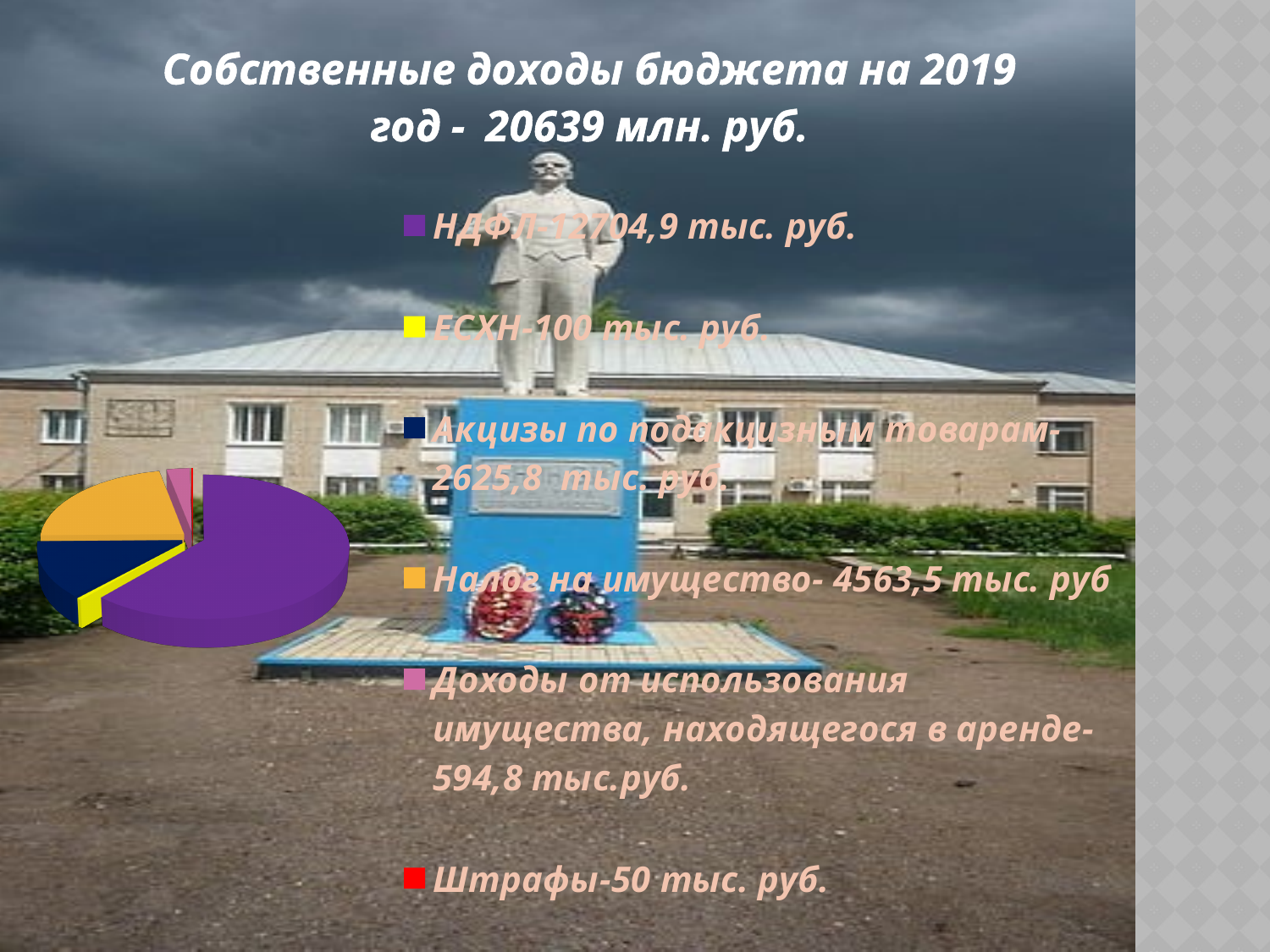
What is the value for Акцизы по подакцизным товарам? 2625,8 тыс. руб. What is the value for Штрафы? 50 тыс. руб. What is the difference between Налог на имущество and Акцизы по подакцизным товарам? 1937,7 тыс. руб. What is the difference between ЕСХН and Штрафы? 50 тыс. руб. How many categories does the pie chart's legend list? 6 Which category has the largest value in the pie chart? НДФЛ What colour is the НДФЛ slice in the pie chart? purple What is the value for Налог на имущество? 4563,5 тыс. руб Which is larger: Акцизы по подакцизным товарам or Налог на имущество? Налог на имущество What is the value for НДФЛ? 12704,9 тыс. руб. What kind of chart is shown on the slide? pie chart Which category has the smallest value in the pie chart? Штрафы